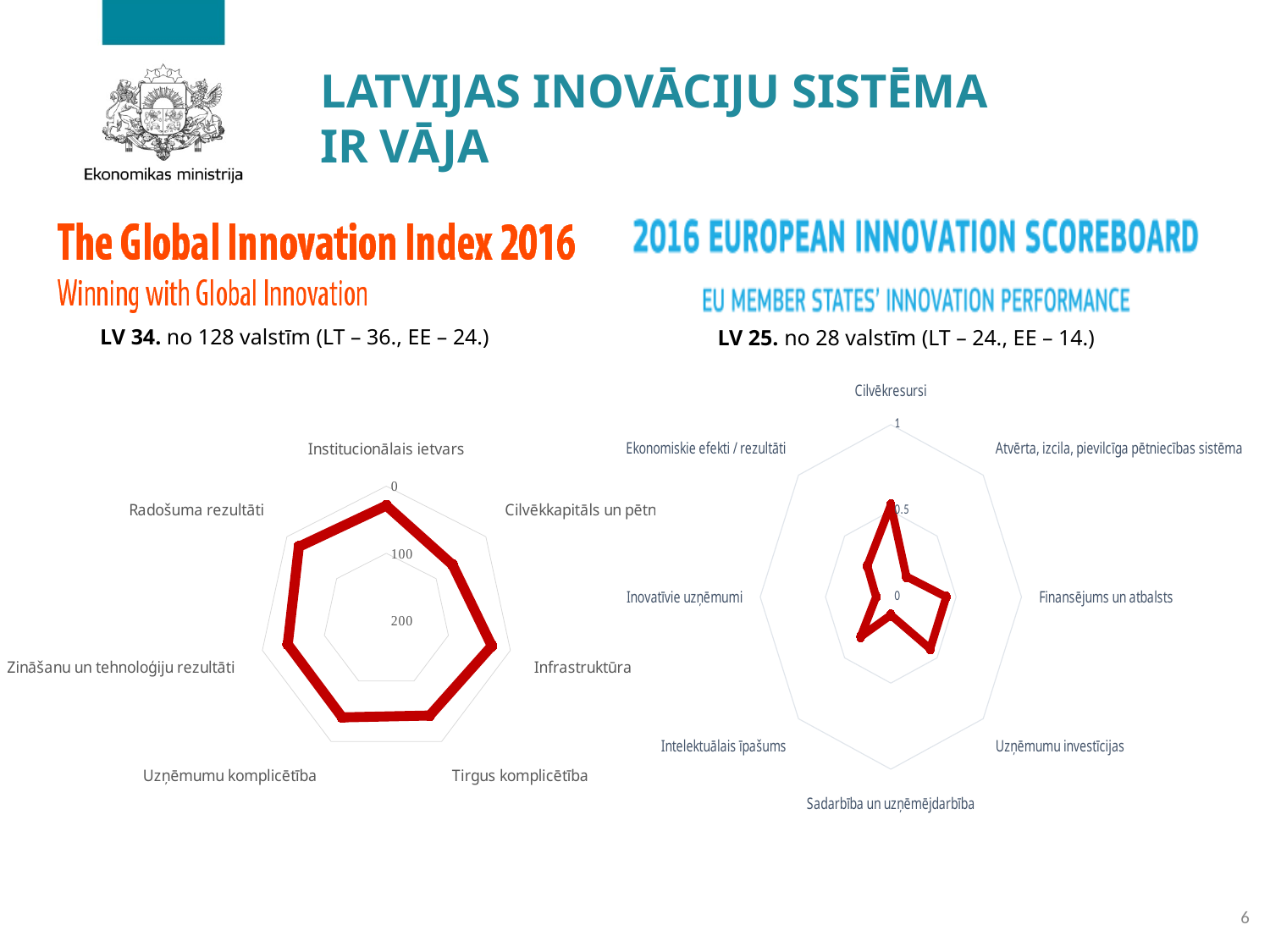
In the right European Innovation Scoreboard chart, is the value for Intelektuālais īpašums greater or less than 0.5? less How many categories (axes) does the right European Innovation Scoreboard radar chart have? 8 What kind of chart is the right chart under '2016 European Innovation Scoreboard'? radar chart What kind of chart is the left chart under 'The Global Innovation Index 2016'? radar chart What is the highest axis tick value shown on the right European Innovation Scoreboard radar chart? 1 In the right European Innovation Scoreboard chart, is the value for Ekonomiskie efekti / rezultāti greater or less than 0.5? less How many categories (axes) does the left Global Innovation Index radar chart have? 7 How many data series are plotted on the right European Innovation Scoreboard radar chart? 1 In the right European Innovation Scoreboard chart, which is larger: the value for Cilvēkresursi or for Ekonomiskie efekti / rezultāti? Cilvēkresursi In the right European Innovation Scoreboard chart, which category has the highest value? Cilvēkresursi What axis tick values are shown on the left Global Innovation Index radar chart? 0, 100, 200